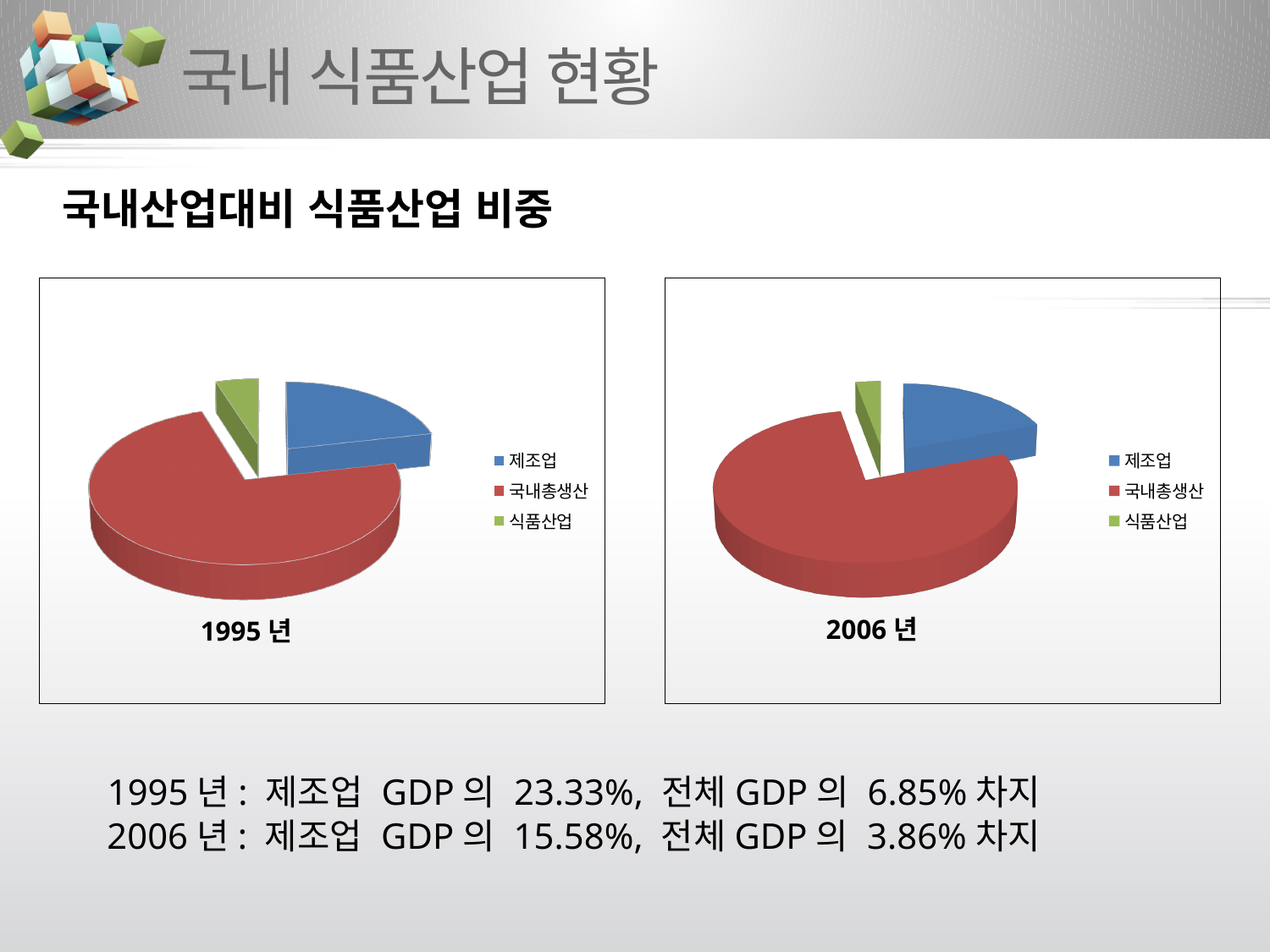
In the 2006 년 chart, which category has the smallest slice? 식품산업 In the 2006 년 chart, what colour is the 식품산업 slice? green What is the title shown below the pie in the left chart? 1995 년 What kind of chart is the 2006 년 chart? pie chart In the 1995 년 chart, which category has the largest slice? 국내총생산 In the 2006 년 chart, which slice is larger, 제조업 or 식품산업? 제조업 How many slices does the 1995 년 pie chart have? 3 How many entries does the legend of the 2006 년 chart list? 3 In the 2006 년 chart, which category has the largest slice? 국내총생산 In the 1995 년 chart, which slice is larger, 국내총생산 or 제조업? 국내총생산 What kind of chart is the 1995 년 chart? pie chart In the 1995 년 chart, which category has the smallest slice? 식품산업